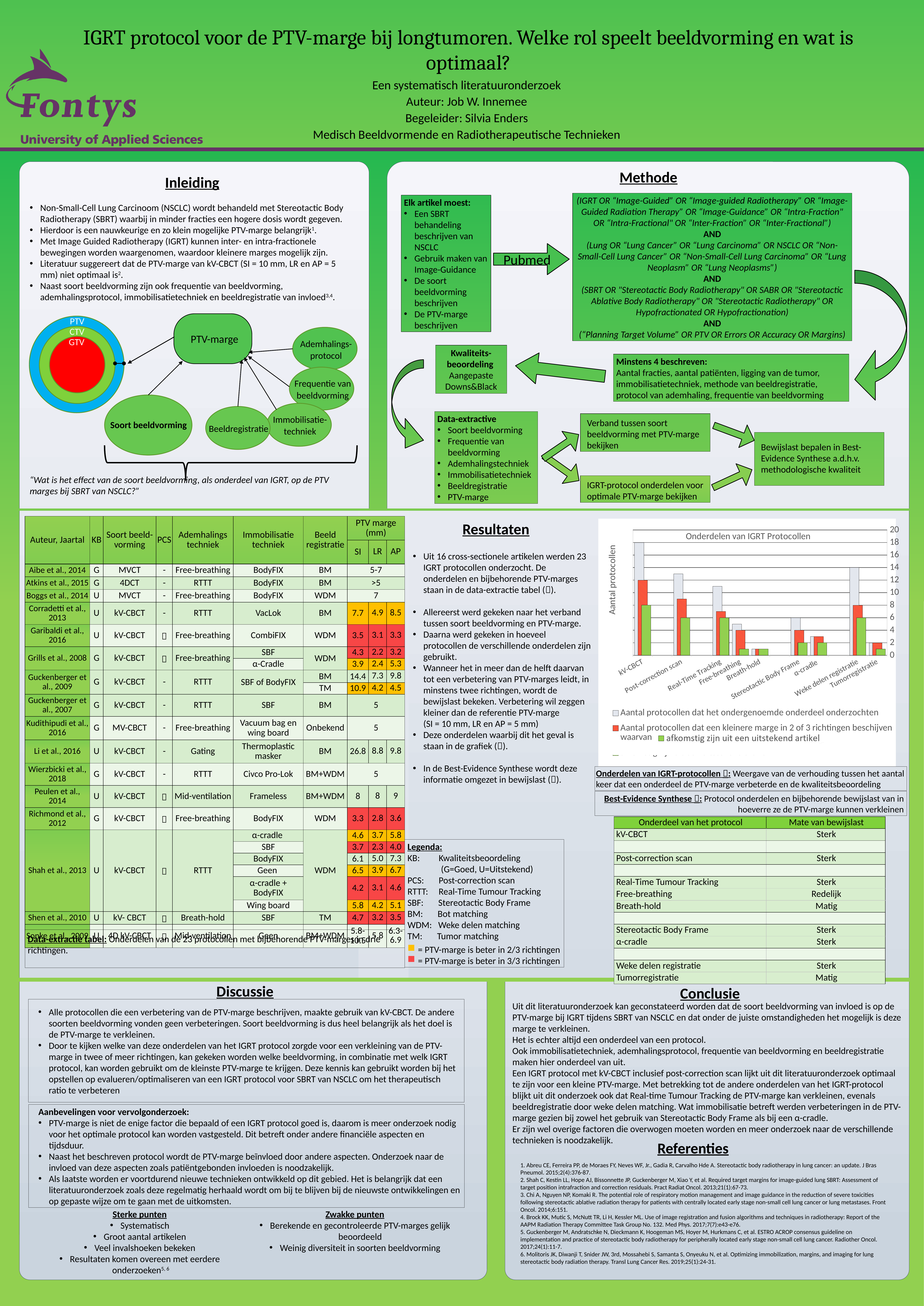
What is the label of the vertical axis of the 'Onderdelen van IGRT Protocollen' chart? Aantal protocollen In the 'Onderdelen van IGRT Protocollen' chart, is the number of protocols that investigated Breath-hold greater or less than 4? less In the 'Onderdelen van IGRT Protocollen' chart, which has more protocols that investigated the component: kV-CBCT or Post-correction scan? kV-CBCT In the 'Onderdelen van IGRT Protocollen' chart, is the number of protocols that investigated kV-CBCT greater or less than 14? greater In the 'Onderdelen van IGRT Protocollen' chart, which has more protocols that investigated the component: Real-Time Tracking or Free-breathing? Real-Time Tracking In the 'Onderdelen van IGRT Protocollen' chart, which has more protocols that investigated the component: Weke delen registratie or Tumorregistratie? Weke delen registratie What is the title of the chart in the Resultaten section? Onderdelen van IGRT Protocollen In the 'Onderdelen van IGRT Protocollen' chart, which category has the highest number of protocols that investigated the component (the light grey bars)? kV-CBCT In the 'Onderdelen van IGRT Protocollen' chart, is the number of protocols that investigated Weke delen registratie greater or less than 10? greater What kind of chart is 'Onderdelen van IGRT Protocollen'? bar chart How many categories are shown on the x axis of the 'Onderdelen van IGRT Protocollen' chart? 9